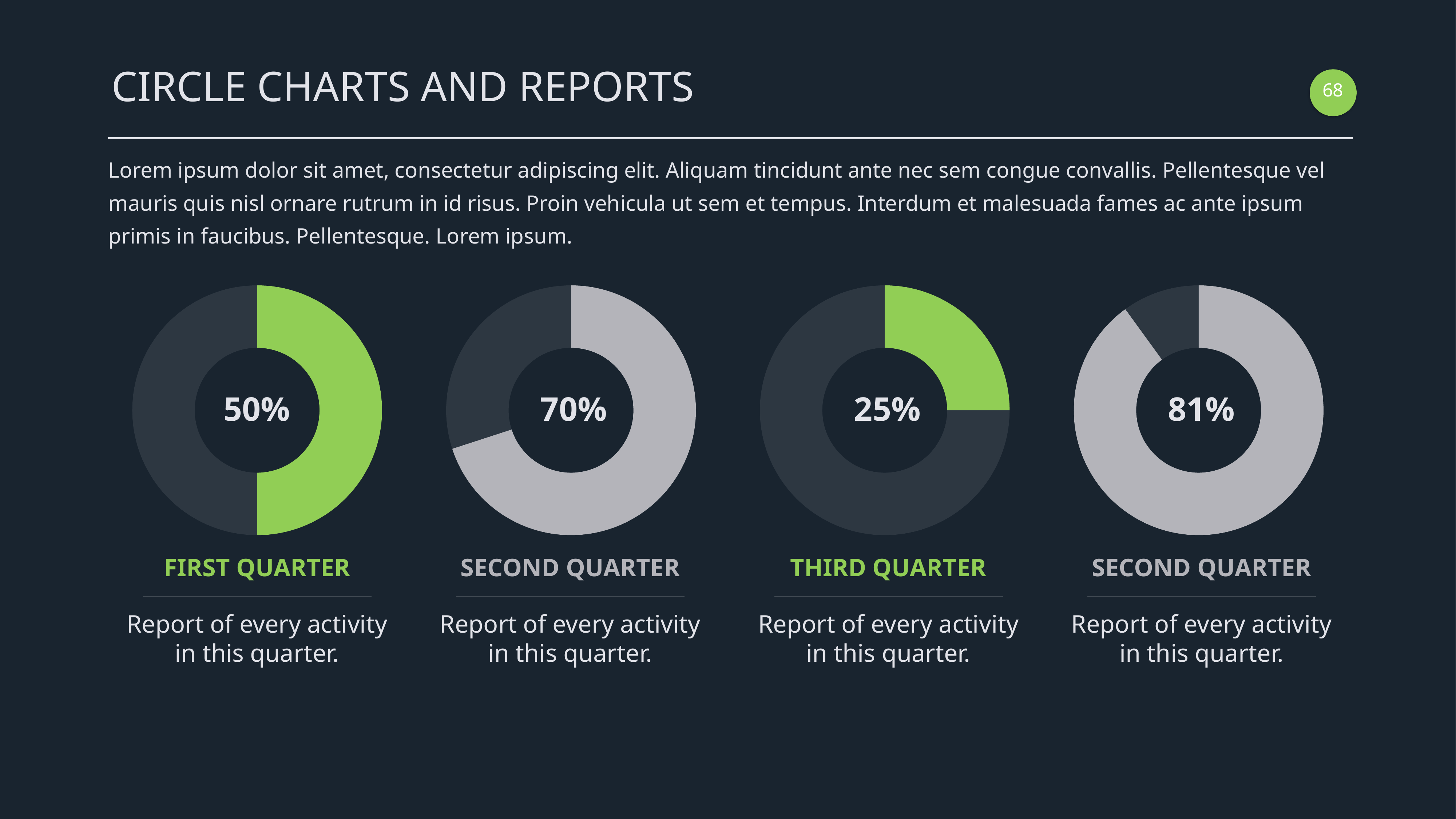
What percentage is shown in the center of the Third Quarter donut chart? 25% What percentage is shown in the center of the First Quarter donut chart? 50% What is the difference between the percentage in the rightmost donut chart and the percentage in the Third Quarter chart? 56% Which donut chart shows the highest percentage? The rightmost chart (81%) Which is larger, the percentage in the First Quarter chart or the percentage in the Third Quarter chart? First Quarter What colour is the filled portion of the First Quarter donut chart? Green What kind of chart is used to show the quarterly percentages on this slide? Donut chart What percentage is shown in the second donut chart from the left, labelled Second Quarter? 70% What percentage is shown in the rightmost donut chart? 81% What is the difference between the percentage in the second chart from the left and the First Quarter chart? 20% Which donut chart shows the lowest percentage? Third Quarter (25%) How many donut charts are shown on the slide? 4